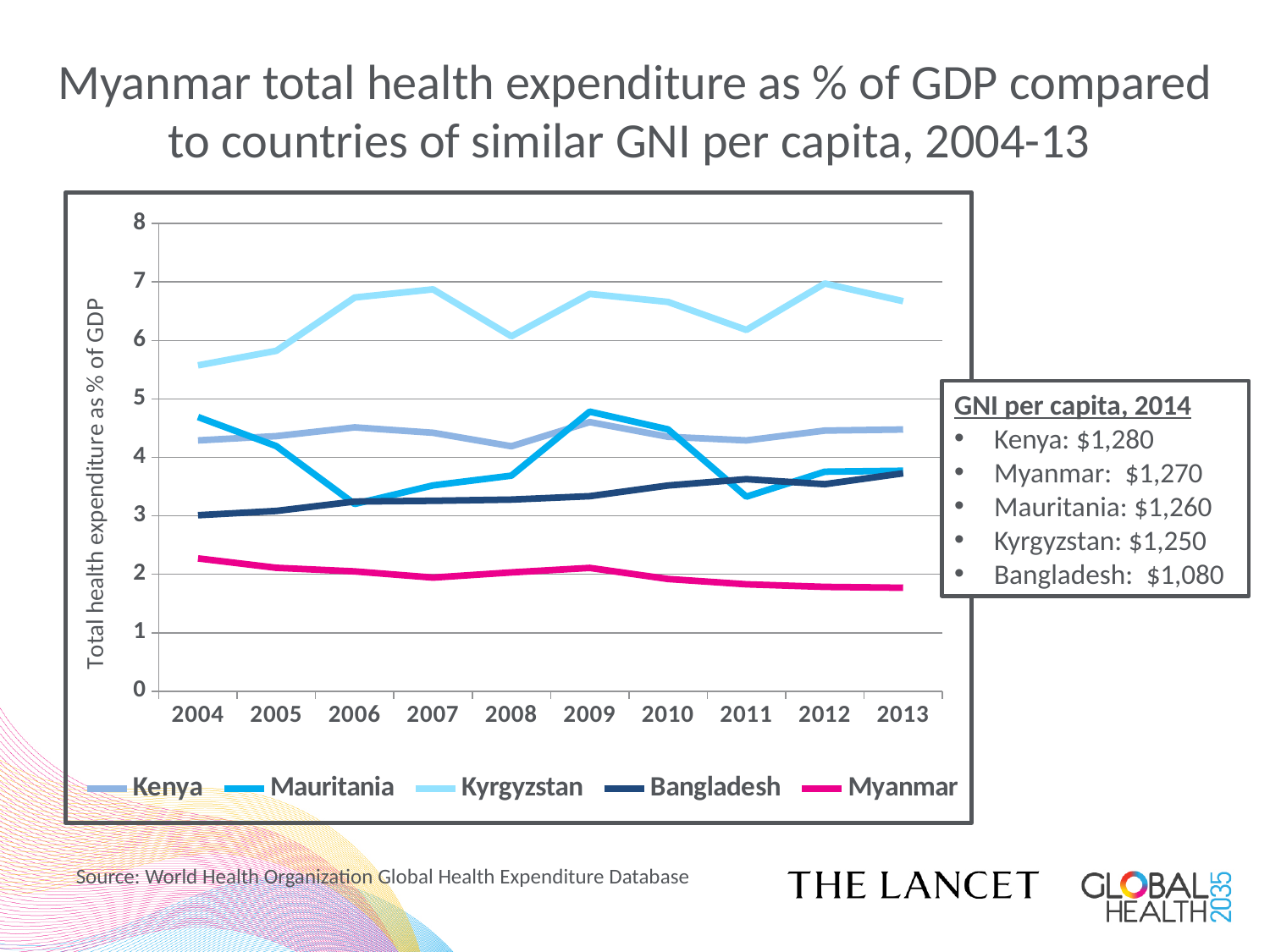
What is the label on the y axis? Total health expenditure as % of GDP What kind of chart is shown on the slide? line chart Which country has the highest total health expenditure as % of GDP across the whole period? Kyrgyzstan Is the value for Kyrgyzstan in 2004 greater or less than 5? greater Is the value for Bangladesh in 2013 greater or less than 3? greater Does the line for Bangladesh generally rise or fall from 2004 to 2013? rise In 2004, which is larger: the value for Mauritania or the value for Bangladesh? Mauritania Which country has the lowest total health expenditure as % of GDP across the whole period? Myanmar Is the value for Kenya in 2006 greater or less than 4? greater How many series does the legend list? 5 How many years are plotted along the x axis? 10